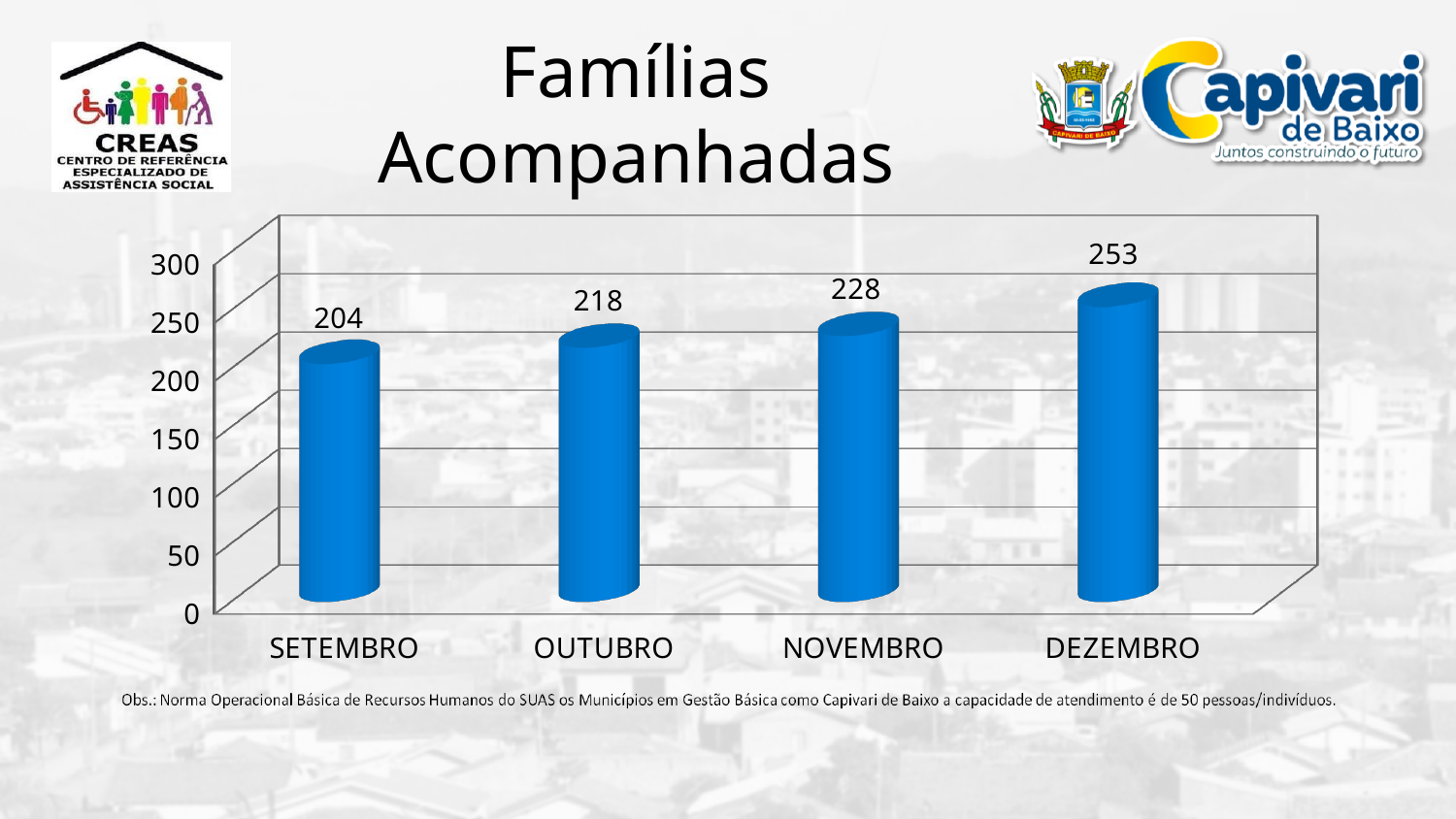
Which month has the lowest value? SETEMBRO Which month has the highest value? DEZEMBRO What is the value for OUTUBRO? 218 What is the value for DEZEMBRO? 253 What is the difference between the values for NOVEMBRO and OUTUBRO? 10 How many months are shown on the chart? 4 What is the difference between the values for DEZEMBRO and SETEMBRO? 49 Which is larger, the value for OUTUBRO or the value for NOVEMBRO? NOVEMBRO What is the value for NOVEMBRO? 228 Do the values rise or fall from SETEMBRO to DEZEMBRO? rise What kind of chart is shown on the slide? bar chart What is the value for SETEMBRO? 204